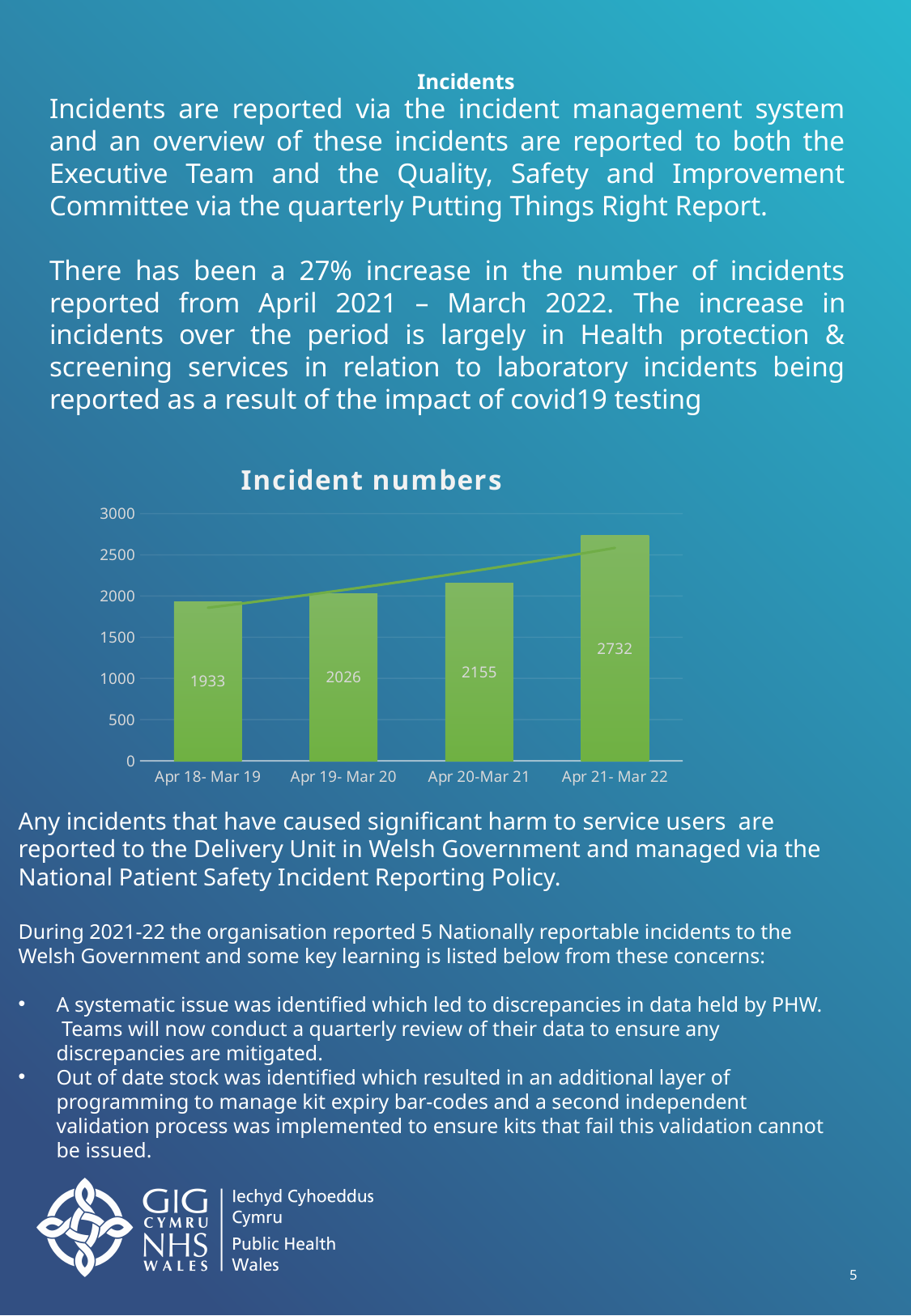
Is the incident number for Apr 21- Mar 22 greater or less than 2500? greater Which period has the highest incident number? Apr 21- Mar 22 What is the incident number for Apr 18- Mar 19? 1933 Do incident numbers rise or fall across the periods shown? Rise What is the incident number for Apr 21- Mar 22? 2732 What is the difference in incident numbers between Apr 19- Mar 20 and Apr 18- Mar 19? 93 What is the incident number for Apr 20-Mar 21? 2155 Which period has the lowest incident number? Apr 18- Mar 19 How many periods are shown in the Incident numbers chart? 4 What kind of chart is used to show incident numbers? Bar chart What is the difference in incident numbers between Apr 21- Mar 22 and Apr 20-Mar 21? 577 Which period has more incidents, Apr 19- Mar 20 or Apr 20-Mar 21? Apr 20-Mar 21